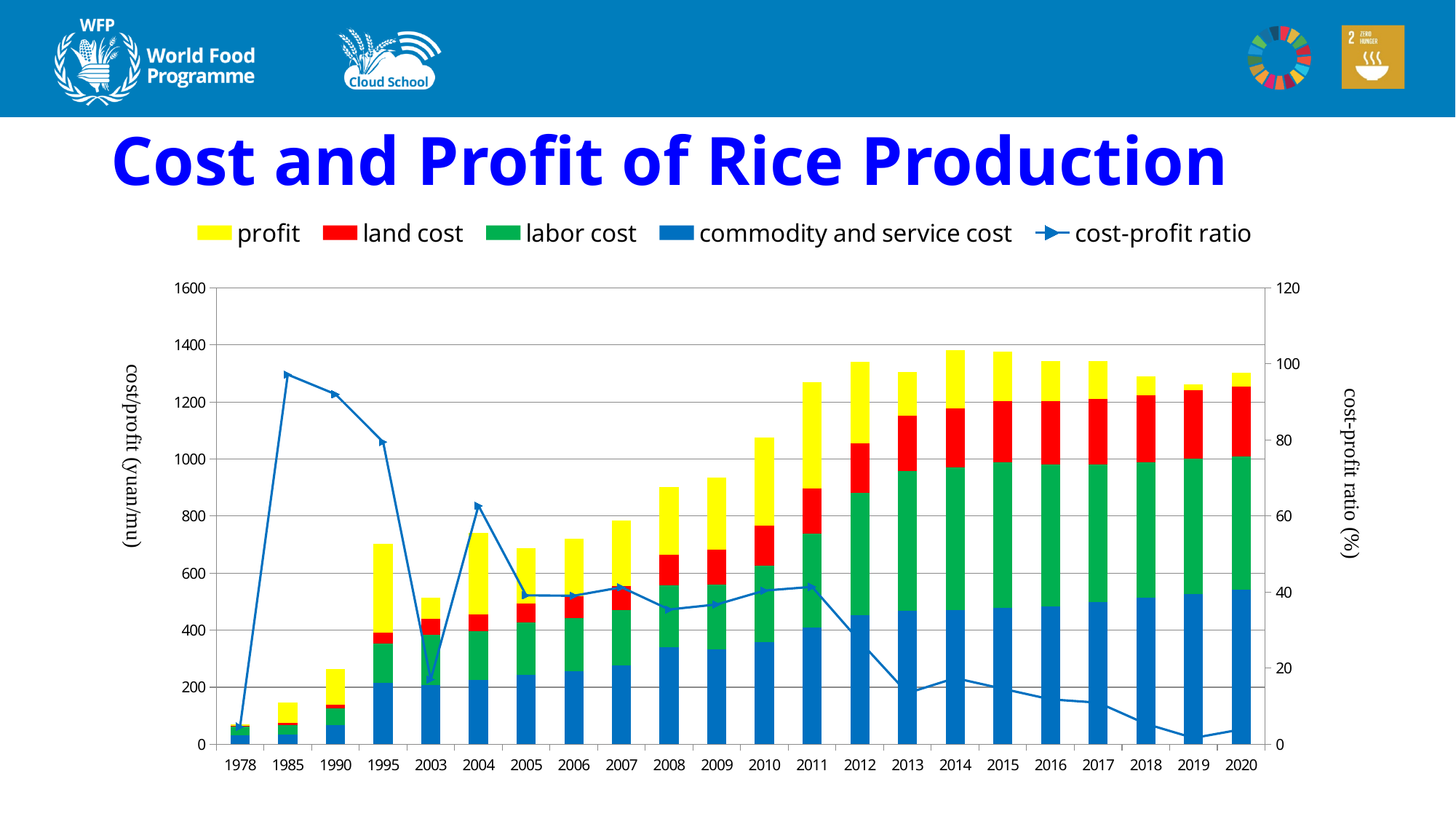
Which year has the lowest total stacked bar? 1978 Is the total stacked bar for 2003 greater or less than 600? less How many years are shown on the x axis? 22 What kind of chart is shown on the slide? Stacked bar chart with a line How many series does the legend list? 5 Which year has the larger total stacked bar, 2010 or 2011? 2011 What is the label of the right-hand vertical axis? cost-profit ratio (%) Is the commodity and service cost for 2020 greater or less than 400? greater In which year is the cost-profit ratio highest? 1985 Is the cost-profit ratio for 2020 greater or less than 20? less Does the commodity and service cost rise or fall from 2003 to 2020? rise